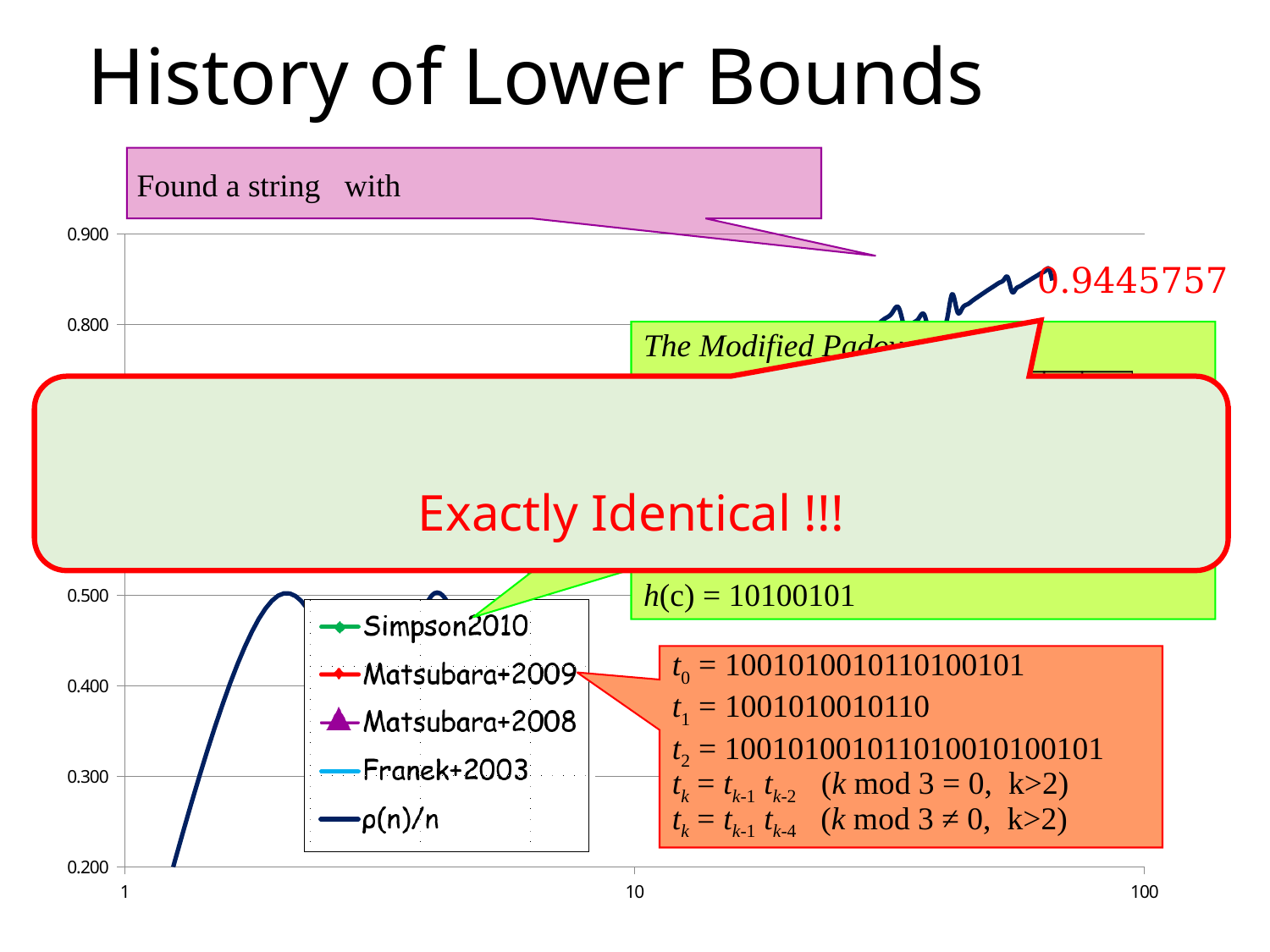
How many series does the chart legend list? 5 Is the leftmost visible point of the ρ(n)/n line greater or less than 0.300? less What kind of chart is shown on the slide? line chart Is the highest visible point of the ρ(n)/n line greater or less than 0.800? greater What is the title of the slide containing the chart? History of Lower Bounds Which series is listed last in the chart legend? ρ(n)/n